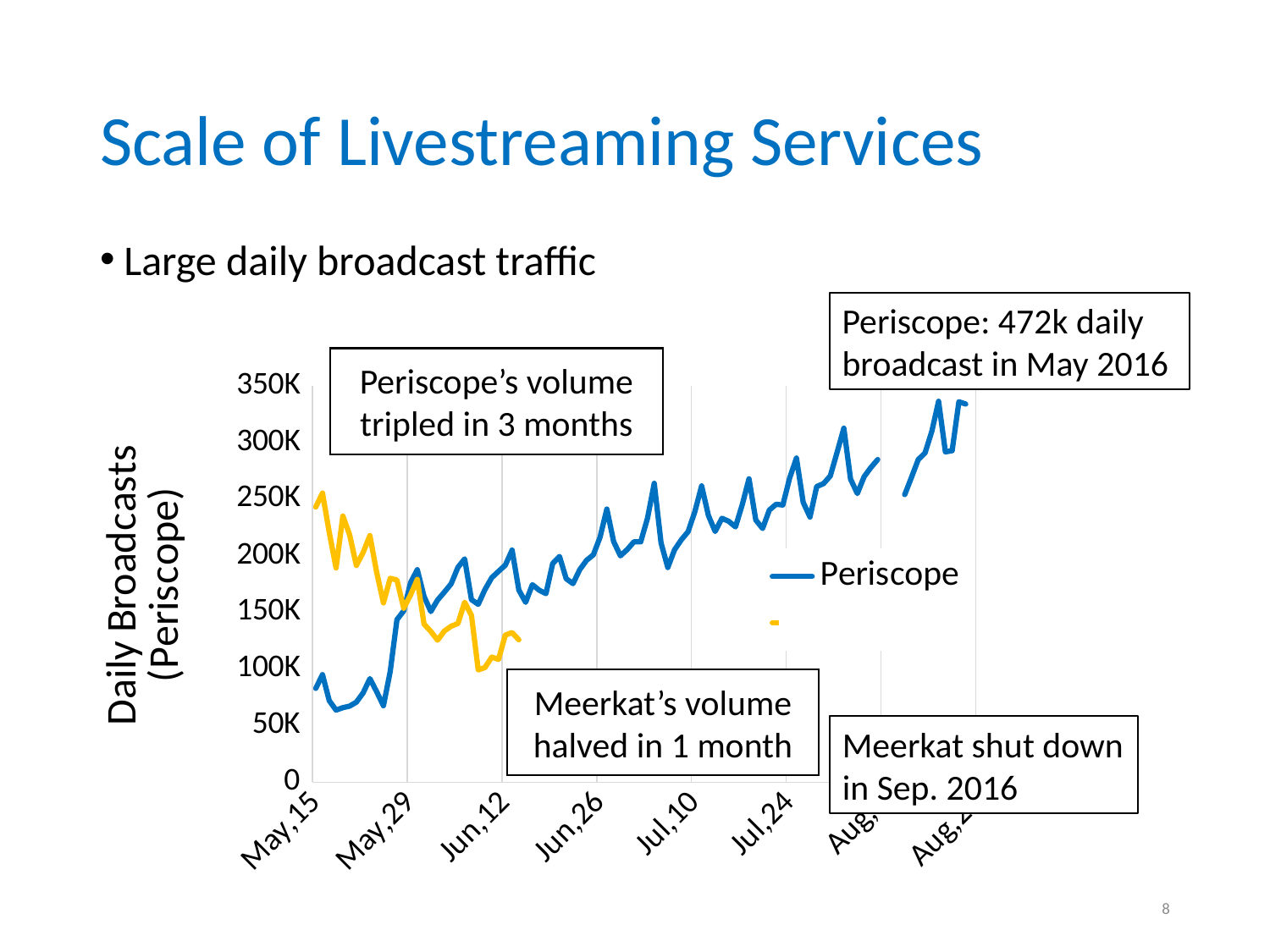
Does the Periscope line generally rise or fall from May,15 to the right end of the chart? rise What is the label of the y axis? Daily Broadcasts (Periscope) At Jun,12, which line is higher, the blue Periscope line or the yellow line? the blue Periscope line Does the yellow line generally rise or fall from May,15 to Jun,12? fall Is the Periscope value at May,15 greater or less than 100K? less How many lines are plotted on the chart? 2 Which series is drawn in blue according to the legend? Periscope What kind of chart is shown on the slide? line chart Is the Periscope value at Jul,24 greater or less than 200K? greater